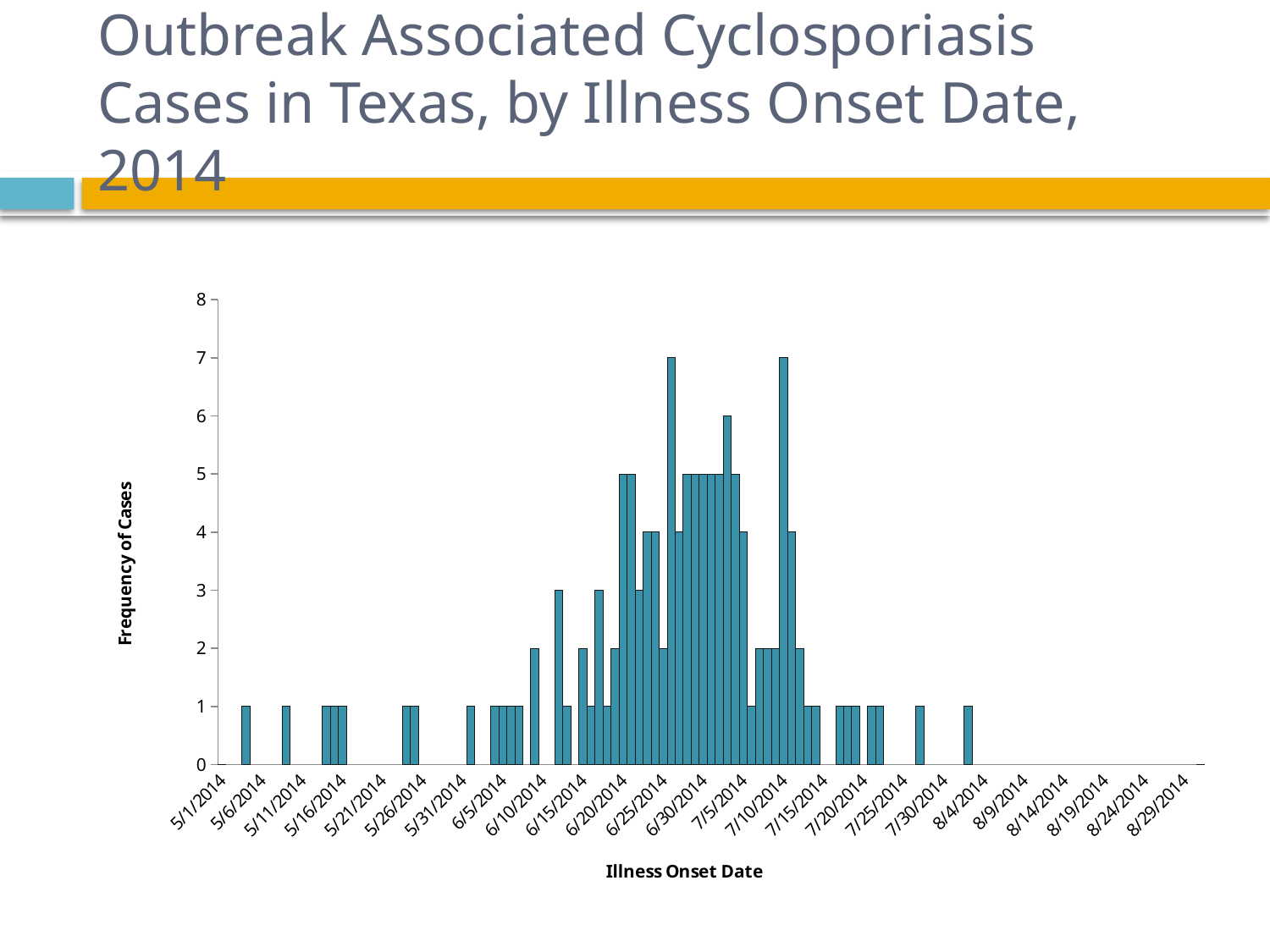
How many bars reach the peak frequency of 7 cases? 2 What is the maximum value shown on the vertical axis? 8 What is the label on the horizontal axis of the chart? Illness Onset Date What kind of chart is shown on the slide? bar chart Are there any cases with an illness onset date after 8/9/2014? No What is the highest frequency of cases reached by any single bar in the chart? 7 Is the frequency of cases for 6/30/2014 greater or less than 4? greater What is the label on the vertical axis of the chart? Frequency of Cases Is the frequency of cases for 7/10/2014 greater or less than 3? greater Do the case frequencies generally rise and then fall across the onset dates, peaking around late June to early July? Yes